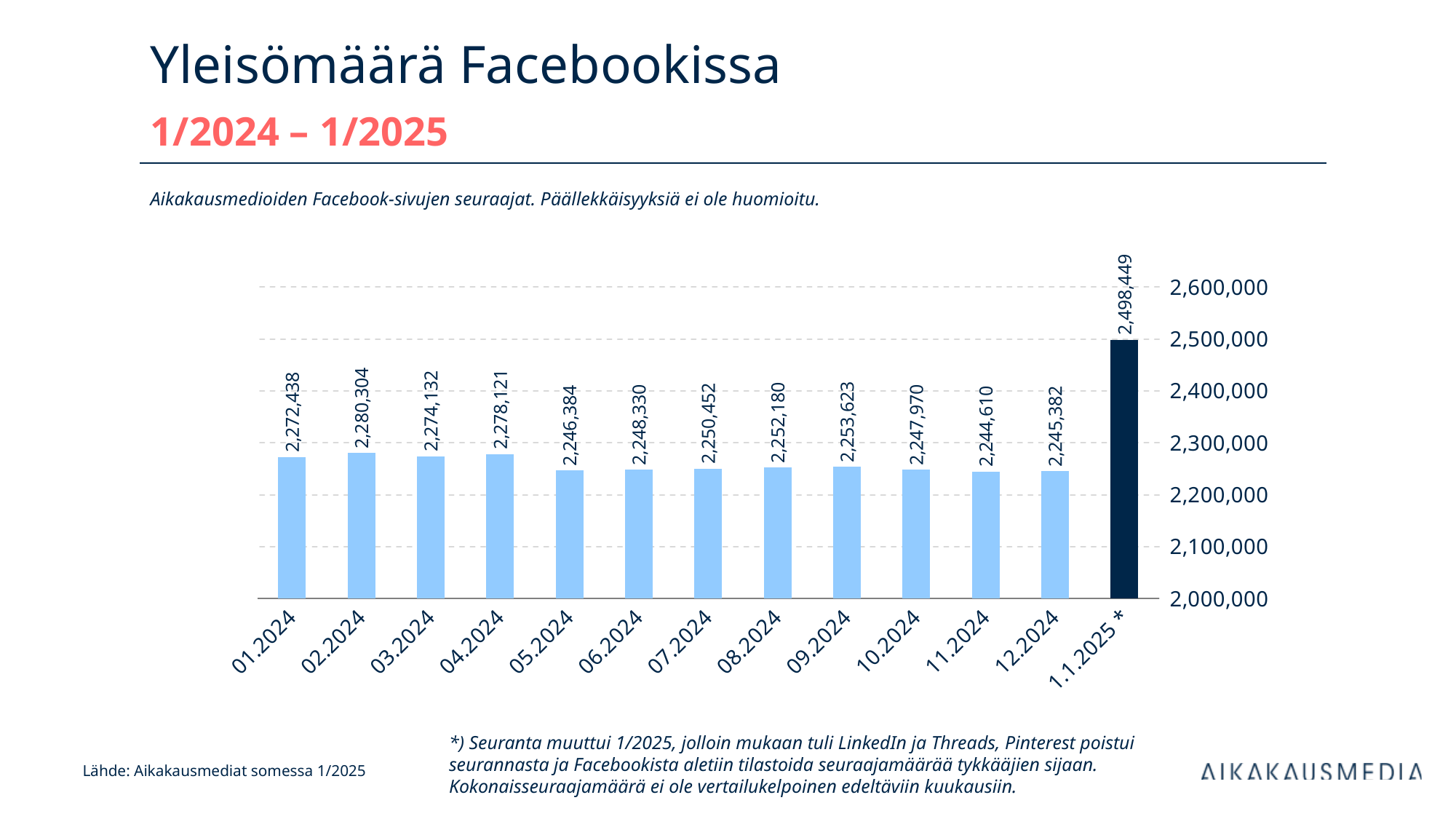
What kind of chart is shown on the slide? bar chart Is the value for 1.1.2025 * greater or less than 2,400,000? greater What is the difference between the values for 02.2024 and 01.2024? 7,866 Which category has the highest value? 1.1.2025 * How many bars are shown in the chart? 13 Which category has the lowest value? 11.2024 What colour is the bar for 1.1.2025 * compared with the other bars? dark navy, the others are light blue What is the value for 01.2024? 2,272,438 Which is larger, the value for 04.2024 or the value for 05.2024? 04.2024 What is the difference between the values for 1.1.2025 * and 12.2024? 253,067 What is the value for 1.1.2025 *? 2,498,449 What is the value for 09.2024? 2,253,623